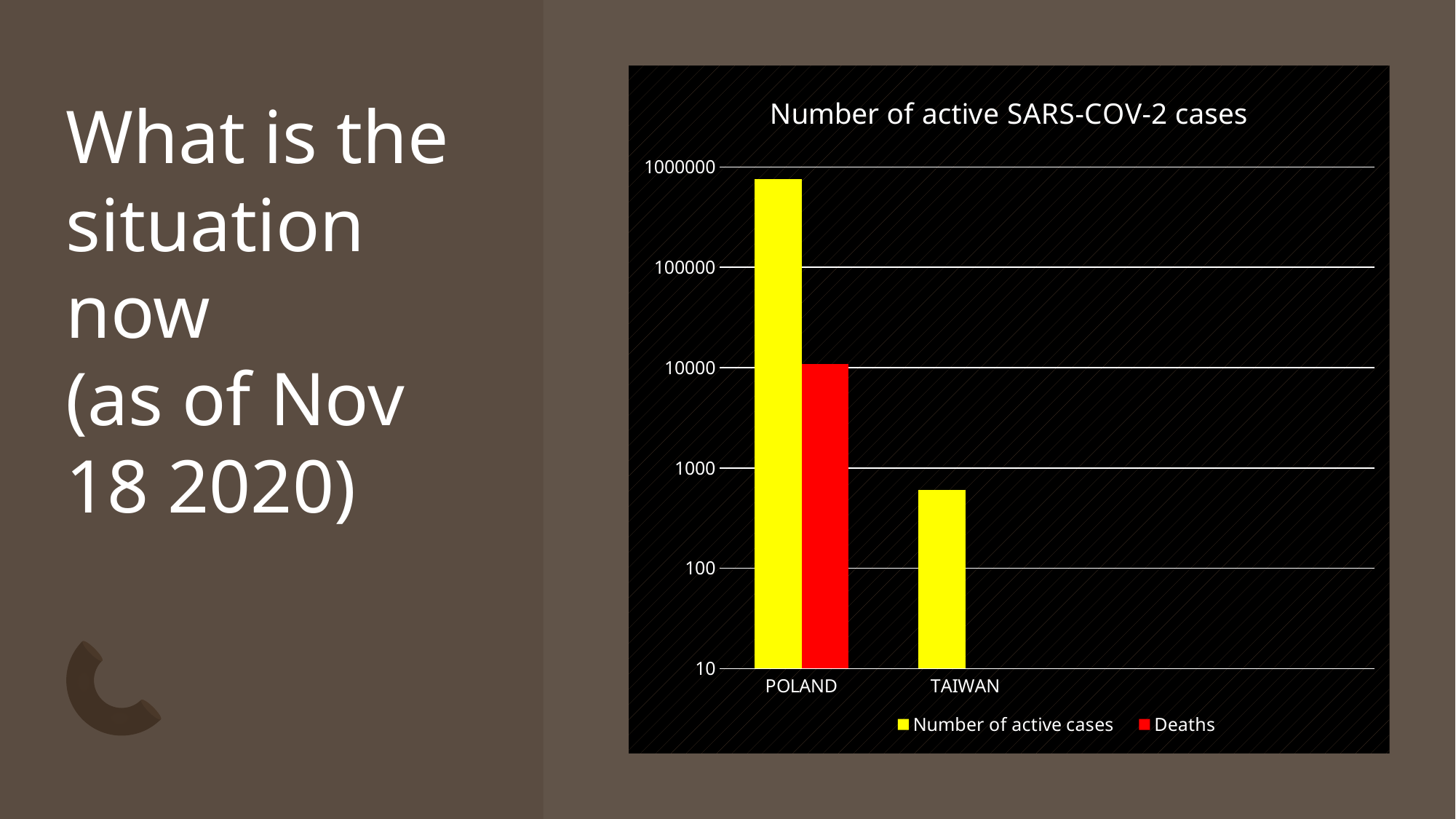
What is the title of the chart? Number of active SARS-COV-2 cases How many countries are shown on the x axis of the chart? 2 Is the number of active cases for POLAND greater or less than 100000? greater Which has more active cases, POLAND or TAIWAN? POLAND How many series does the chart legend list? 2 What colour represents the Deaths series in the chart? red Which country has the lowest number of active cases? TAIWAN Which country has the highest number of active cases? POLAND Is the number of active cases for TAIWAN greater or less than 1000? less Is the number of active cases for POLAND greater or less than 1000000? less What kind of chart is shown on the slide? bar chart